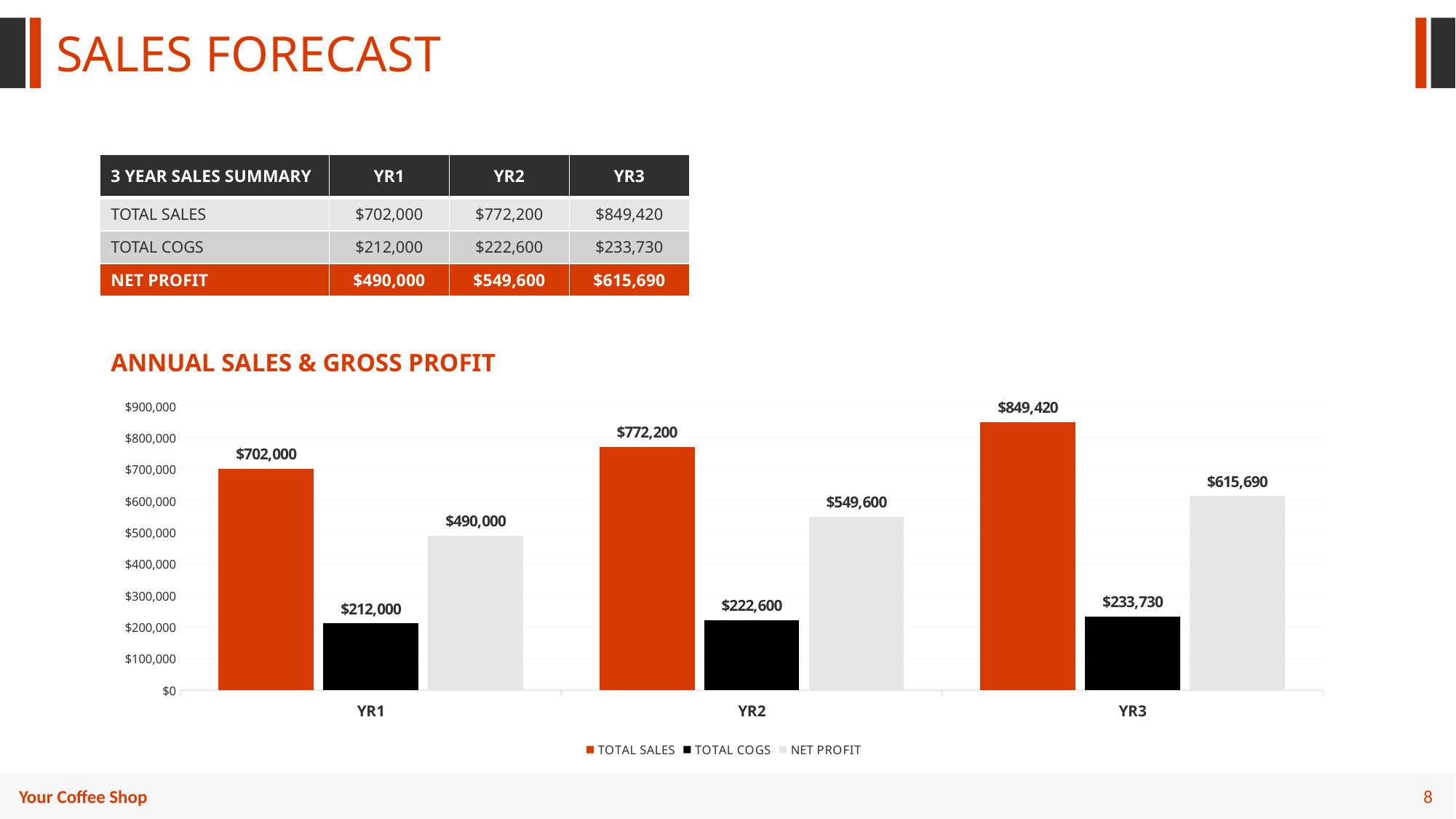
What is the NET PROFIT value for YR3 in the chart? $615,690 What is the TOTAL COGS value for YR1 in the chart? $212,000 Which is larger: NET PROFIT in YR2 or TOTAL COGS in YR3? NET PROFIT in YR2 What is the difference between TOTAL SALES in YR3 and YR1? $147,420 How many year categories are shown on the x axis of the chart? 3 Which year has the highest TOTAL SALES in the chart? YR3 What kind of chart is shown on the slide? bar chart How many series does the chart legend list? 3 Is the TOTAL COGS value for YR3 greater or less than $300,000? less Do the TOTAL SALES values rise or fall from YR1 to YR3? rise What is the TOTAL SALES value for YR2 in the chart? $772,200 Which year has the lowest NET PROFIT in the chart? YR1